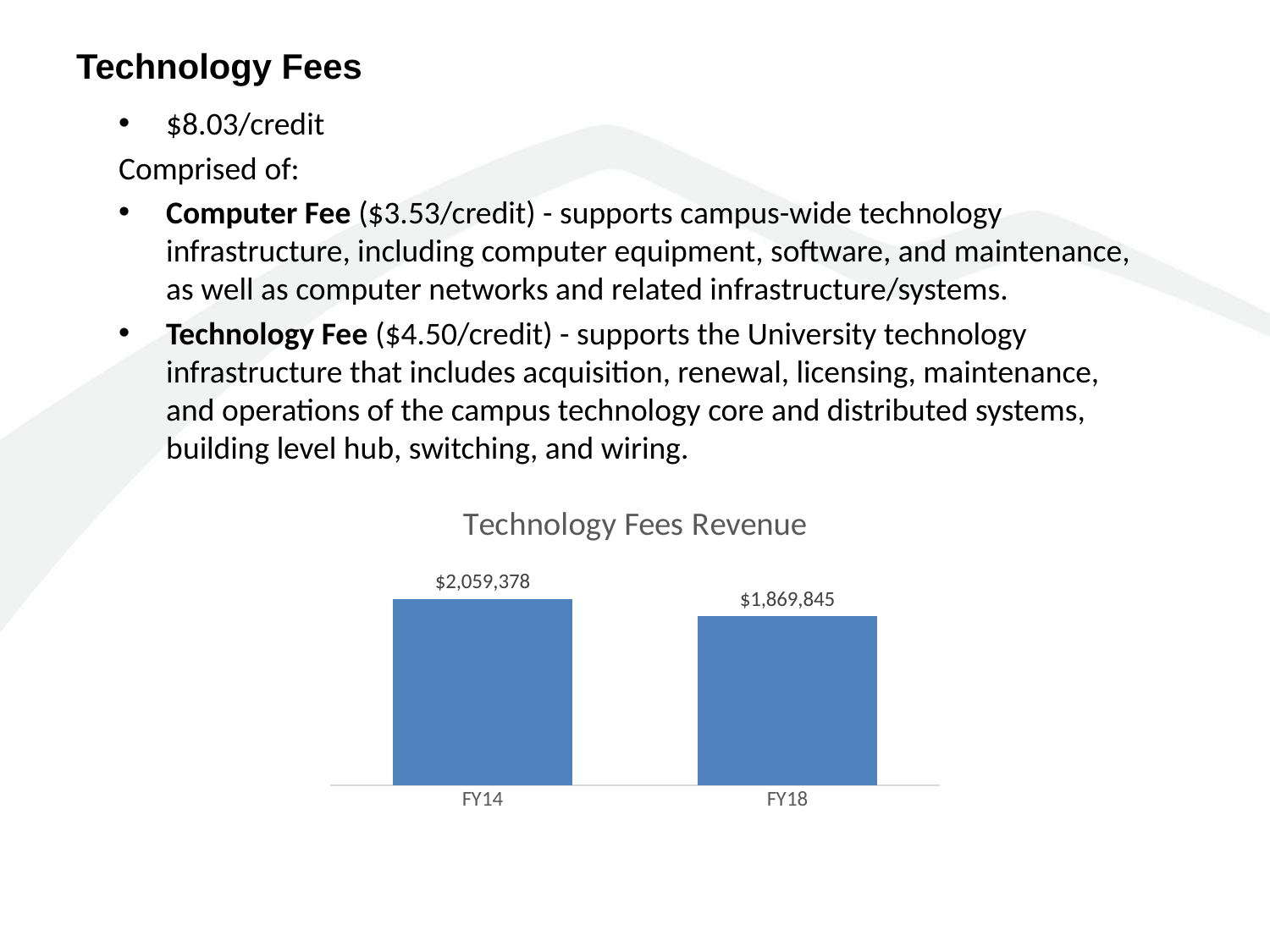
Which fiscal year has the lower Technology Fees Revenue? FY18 How many fiscal years are shown in the Technology Fees Revenue chart? 2 What is the title of the chart on the slide? Technology Fees Revenue What colour are the bars in the Technology Fees Revenue chart? Blue What is the Technology Fees Revenue for FY18? $1,869,845 Does the Technology Fees Revenue rise or fall from FY14 to FY18? Fall Which fiscal year has the higher Technology Fees Revenue? FY14 What type of chart is used to show Technology Fees Revenue? Bar chart What is the difference between the FY14 and FY18 Technology Fees Revenue? $189,533 What is the Technology Fees Revenue for FY14? $2,059,378 Is the Technology Fees Revenue larger in FY14 or FY18? FY14